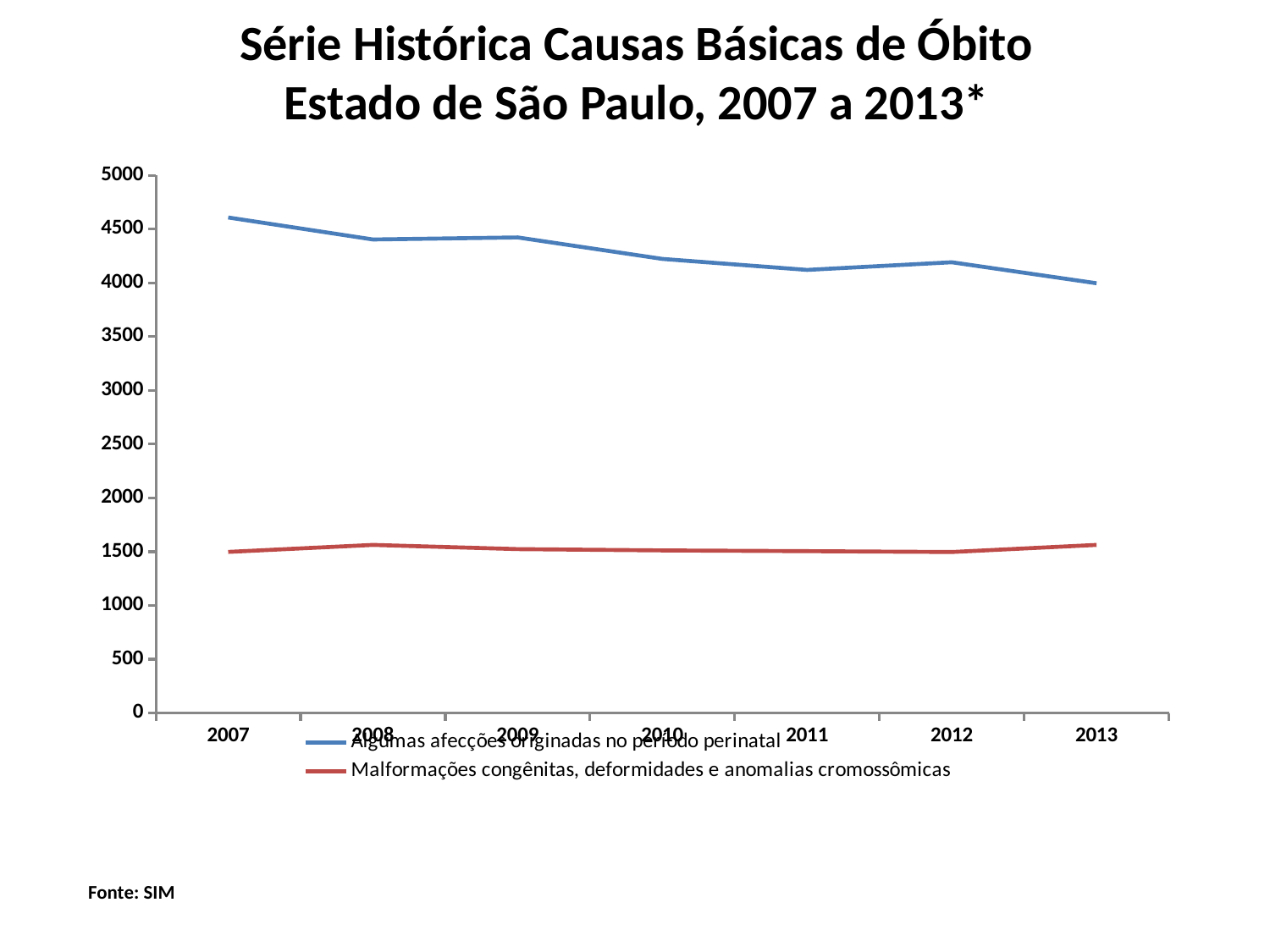
Is the value for 'Algumas afecções originadas no período perinatal' in 2011 greater or less than 4500? less In 2010, which series has the larger value: 'Algumas afecções originadas no período perinatal' or 'Malformações congênitas, deformidades e anomalias cromossômicas'? Algumas afecções originadas no período perinatal How many years are plotted along the x axis? 7 Is the value for 'Malformações congênitas, deformidades e anomalias cromossômicas' in 2010 greater or less than 2000? less Which colour is used for the 'Malformações congênitas, deformidades e anomalias cromossômicas' line? red In which year is the value for 'Algumas afecções originadas no período perinatal' lowest? 2013 How many series does the legend list? 2 Is the value for 'Algumas afecções originadas no período perinatal' in 2007 greater or less than 4500? greater Does the line for 'Algumas afecções originadas no período perinatal' generally rise or fall from 2007 to 2013? fall What kind of chart is shown on the slide? line chart In which year is the value for 'Algumas afecções originadas no período perinatal' highest? 2007